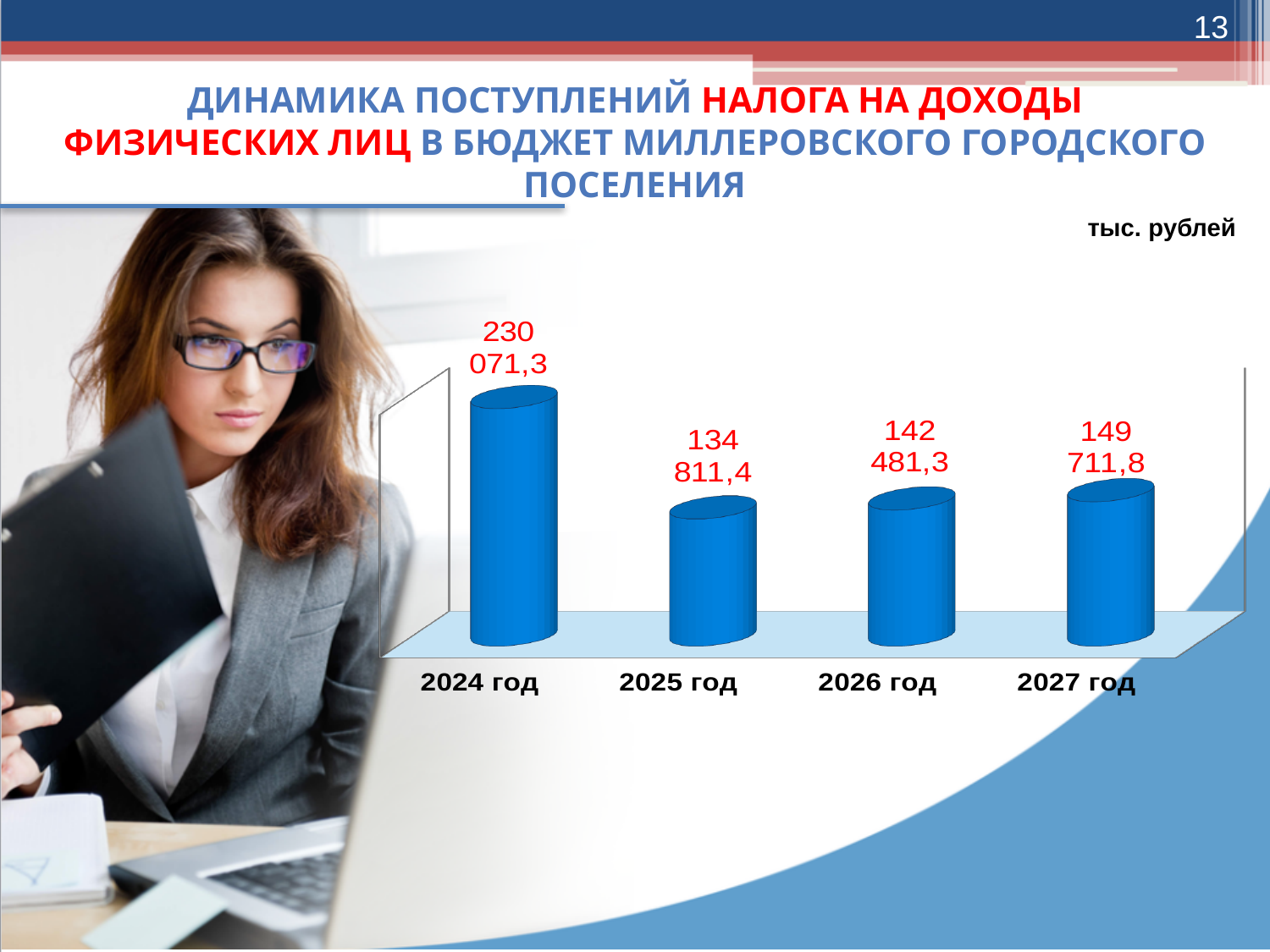
What is the difference between the values for 2027 год and 2026 год? 7 230,5 What is the value for 2026 год? 142 481,3 What is the value for 2027 год? 149 711,8 Which year has the lowest value? 2025 год What kind of chart is shown on the slide? bar chart What is the value for 2025 год? 134 811,4 What is the difference between the values for 2024 год and 2025 год? 95 259,9 Do the values rise or fall from 2025 год to 2027 год? rise Which year has the highest value? 2024 год How many years are shown on the chart? 4 What is the value for 2024 год? 230 071,3 Which is larger, the value for 2026 год or the value for 2027 год? 2027 год